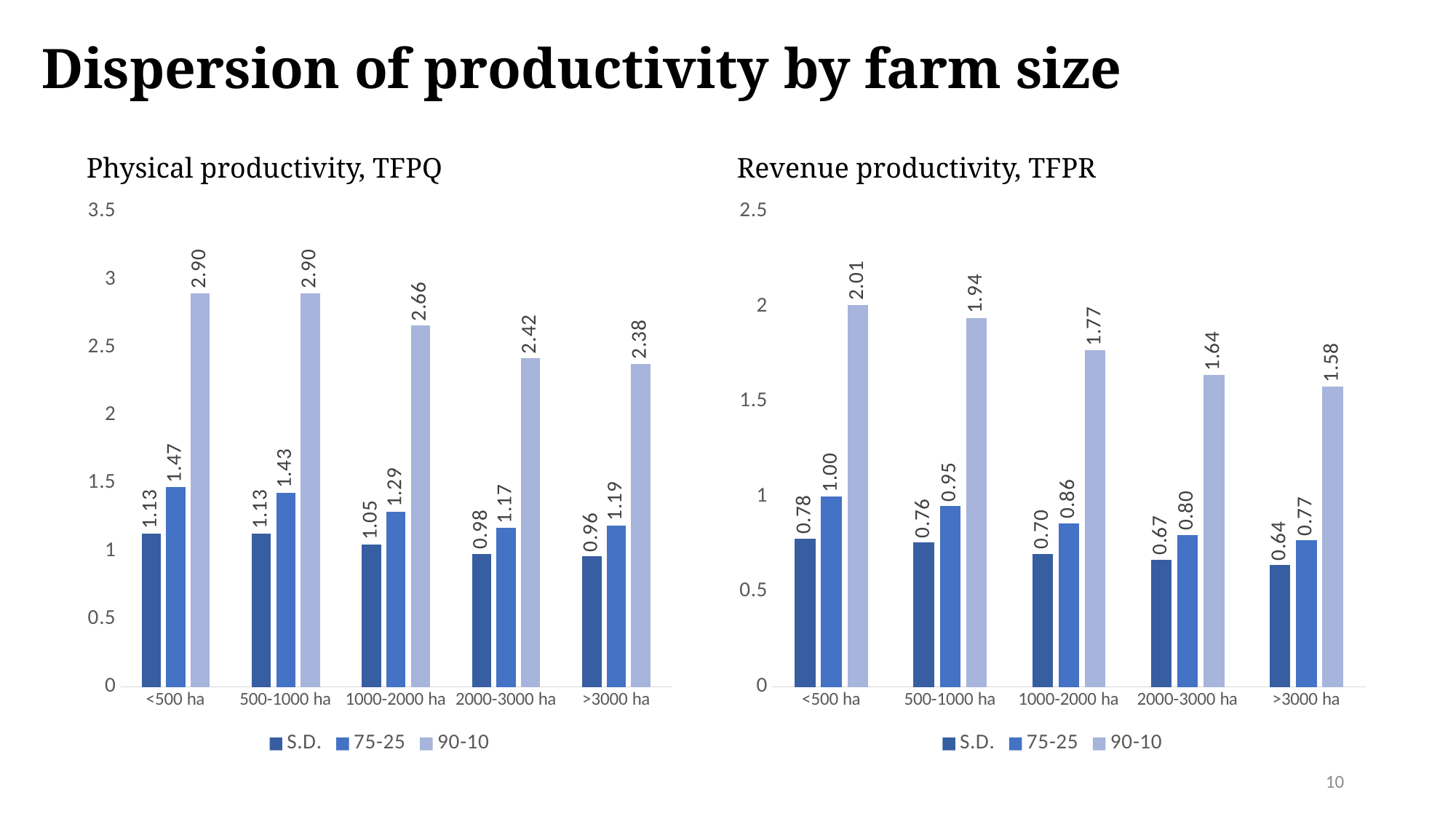
How many series does the legend of the 'Revenue productivity, TFPR' chart list? 3 In the 'Revenue productivity, TFPR' chart, do the 90-10 values rise or fall as farm size increases along the x axis? fall How many farm size categories are shown on the x axis of the 'Physical productivity, TFPQ' chart? 5 In the 'Physical productivity, TFPQ' chart, which is larger: the 75-25 value for 500-1000 ha or the 75-25 value for 1000-2000 ha? 500-1000 ha In the 'Physical productivity, TFPQ' chart, what is the 90-10 value for farms of 1000-2000 ha? 2.66 In the 'Revenue productivity, TFPR' chart, what is the difference between the 75-25 value and the S.D. value for farms of 2000-3000 ha? 0.13 In the 'Revenue productivity, TFPR' chart, what is the S.D. value for farms of >3000 ha? 0.64 In the 'Physical productivity, TFPQ' chart, which farm size category has the lowest S.D. value? >3000 ha In the 'Revenue productivity, TFPR' chart, is the 90-10 value for 1000-2000 ha greater or less than 1.5? greater In the 'Revenue productivity, TFPR' chart, what is the 75-25 value for farms of <500 ha? 1.00 In the 'Revenue productivity, TFPR' chart, which farm size category has the highest 90-10 value? <500 ha In the 'Physical productivity, TFPQ' chart, what is the difference between the 90-10 value for <500 ha and the 90-10 value for >3000 ha? 0.52